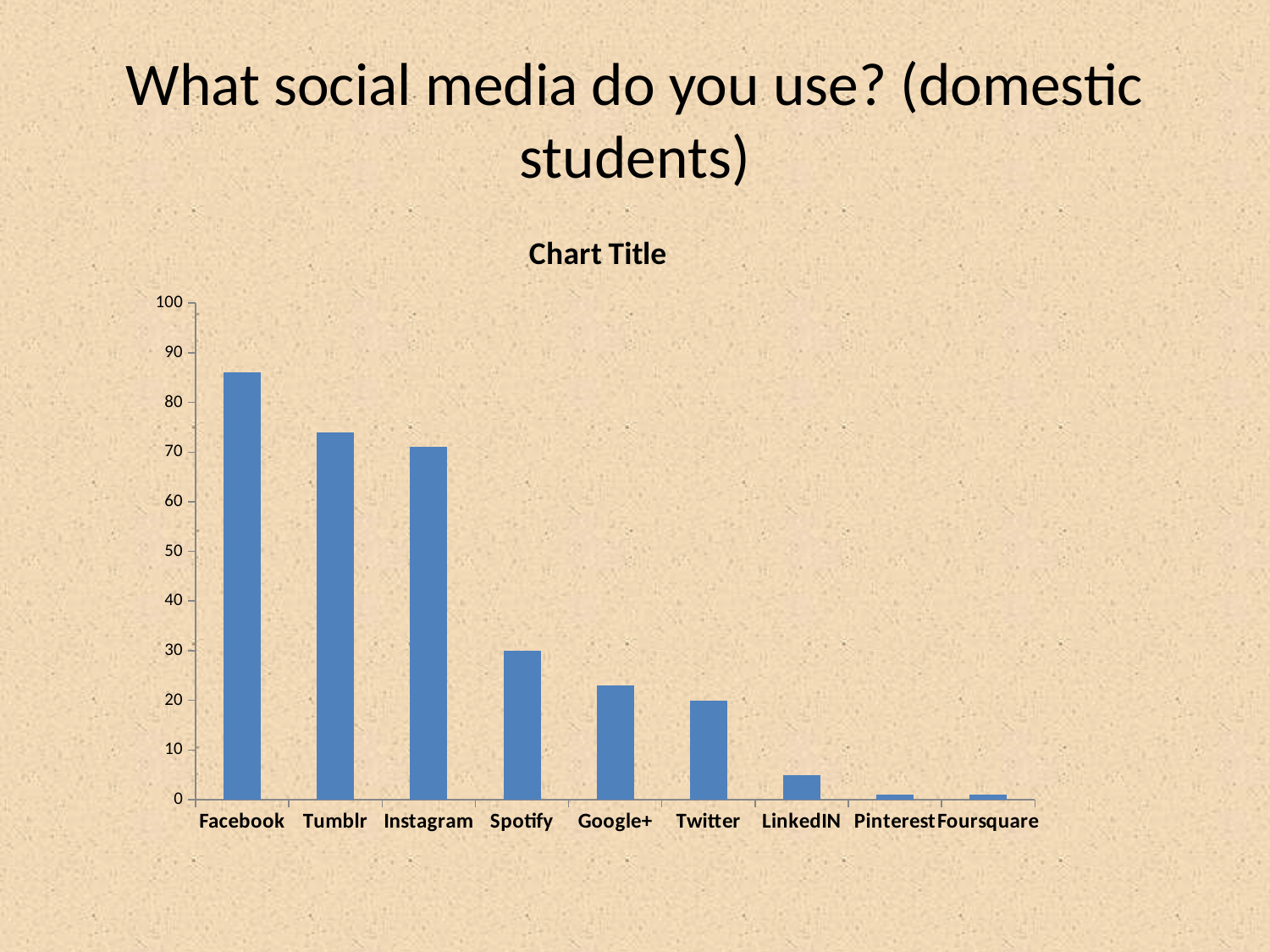
Is the value for Spotify greater or less than 40? less Is the value for LinkedIN greater or less than 10? less Is the value for Facebook greater or less than 80? greater What is the title printed above the chart? Chart Title How many social media categories are shown on the x axis? 9 Which has a larger value, Tumblr or Spotify? Tumblr Which social media category has the highest value? Facebook Do the values generally rise or fall moving from left to right along the x axis? fall What kind of chart is shown on the slide? bar chart